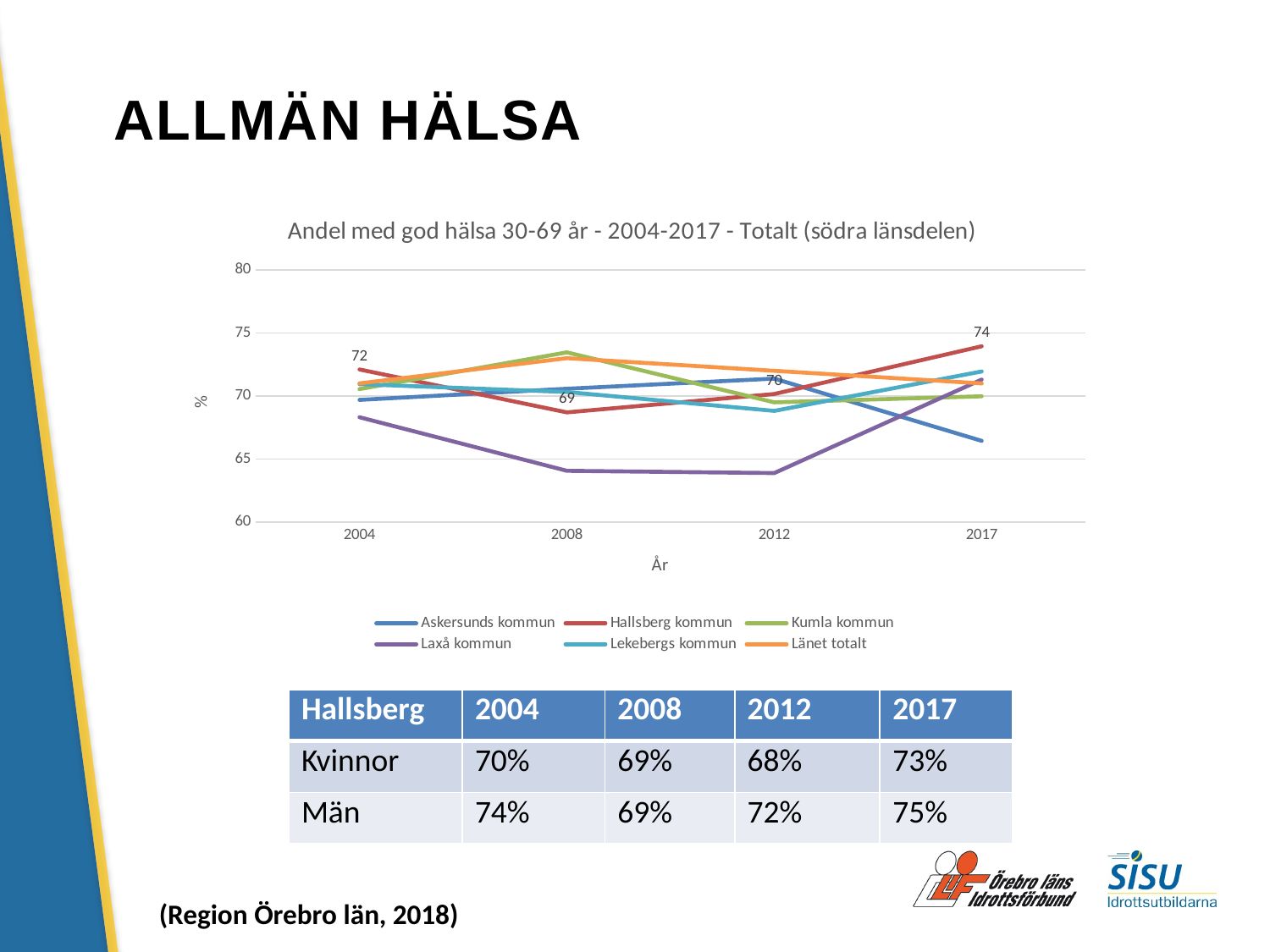
Which series has the highest value in 2017? Hallsberg kommun How many years are shown on the x axis of the chart? 4 What is the value for Hallsberg kommun in 2017? 74 What is the value for Hallsberg kommun in 2008? 69 What is the difference between the Hallsberg kommun values for 2017 and 2008? 5 Which series has the lowest value in 2008? Laxå kommun What is the value for Hallsberg kommun in 2004? 72 How many series does the legend of the chart list? 6 What kind of chart is shown on the slide? line chart Which is larger for Hallsberg kommun, the value in 2004 or the value in 2017? 2017 Is the value for Laxå kommun in 2012 greater or less than 65? less What is the title of the chart? Andel med god hälsa 30-69 år - 2004-2017 - Totalt (södra länsdelen)